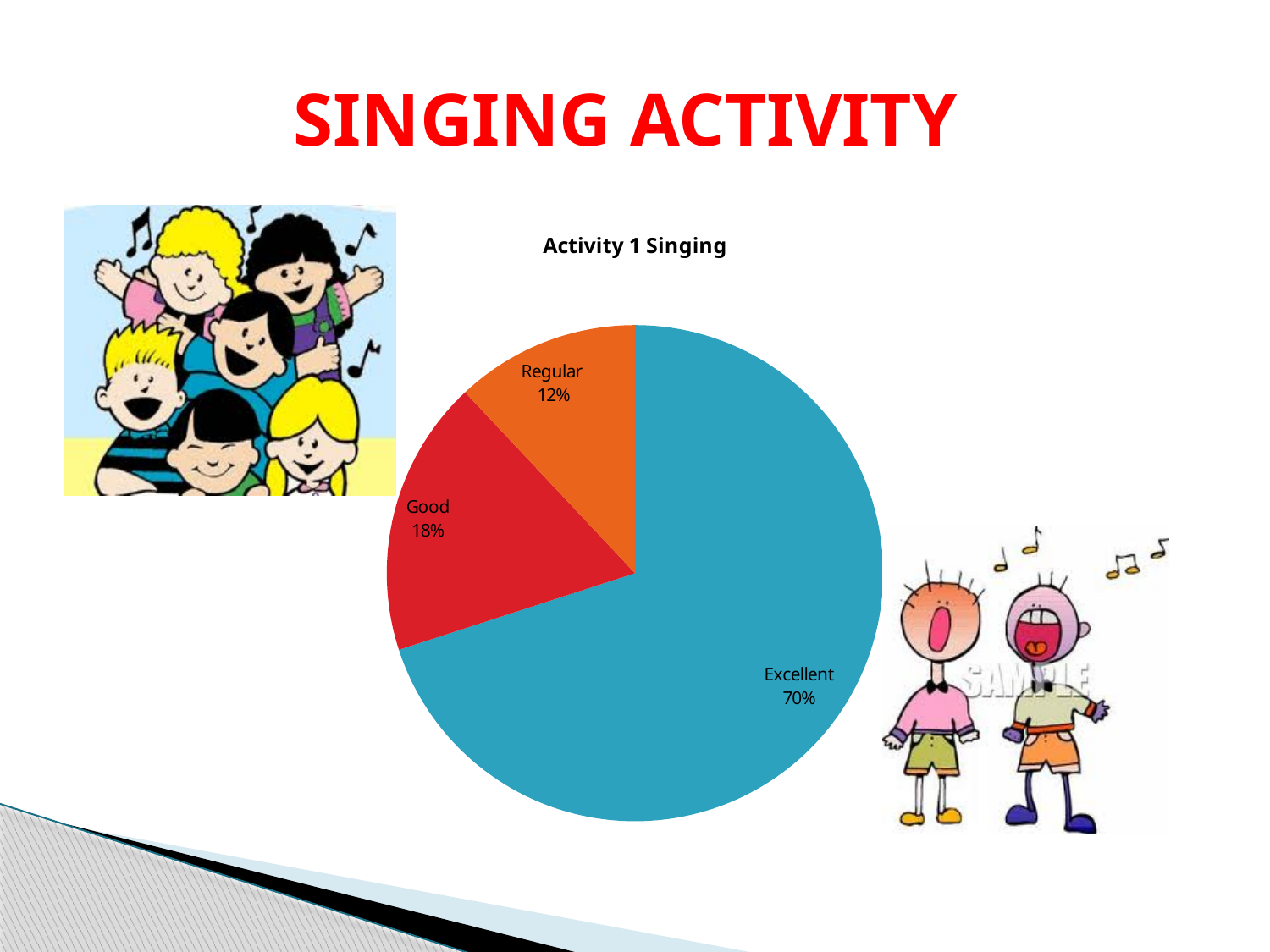
What colour is the Excellent slice? blue What is the title of the chart? Activity 1 Singing What type of chart is shown on the slide? pie chart What is the difference in percentage points between the Good and Regular slices? 6 What percentage of the pie is labelled Excellent? 70% What percentage of the pie is labelled Regular? 12% What percentage of the pie is labelled Good? 18% How many slices does the pie chart have? 3 What is the difference in percentage points between the Excellent and Good slices? 52 Which slice is larger, Good or Regular? Good Which category has the smallest share of the pie? Regular Which category has the largest share of the pie? Excellent